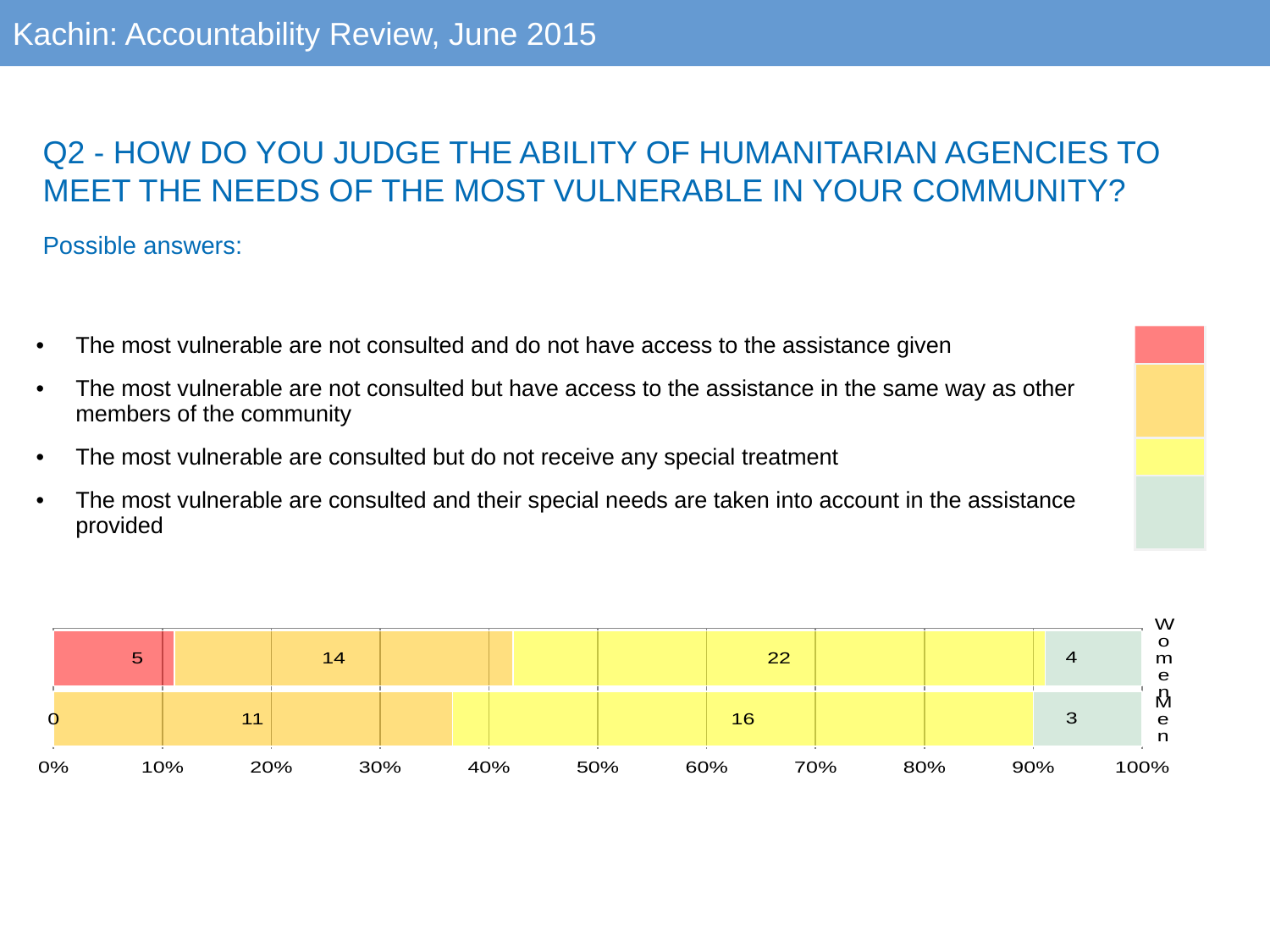
What is the value of the red segment in the Men bar? 0 In the Men bar, what is the value of the yellow segment (consulted but do not receive any special treatment)? 16 What is the value of the green segment in the Women bar? 4 What type of chart is shown on the slide? Stacked bar chart Which group has the larger orange segment value, Women or Men? Women What is the value of the orange segment in the Men bar? 11 How many groups (bars) are shown in the chart? 2 What is the total number of responses in the Men bar? 30 What is the difference between the yellow segment values for Women and Men? 6 What is the total number of responses in the Women bar? 45 Which segment has the largest value in the Women bar? The yellow segment (consulted but do not receive any special treatment), with 22 In the Women bar, how many respondents said the most vulnerable are not consulted and do not have access to the assistance given (red segment)? 5